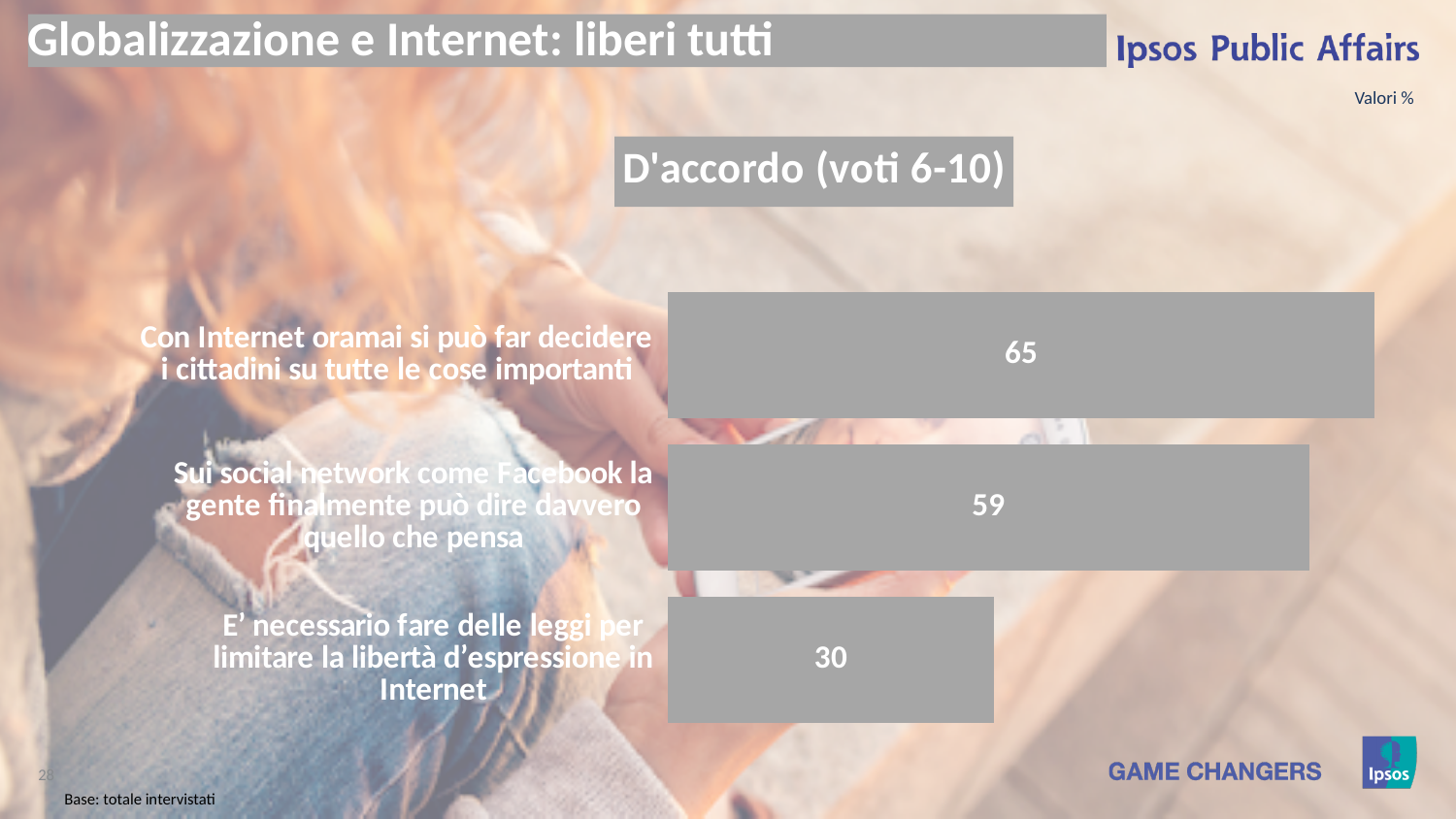
What is the difference between the values for the Internet-decision statement and the Facebook statement? 6 Which statement has the lowest level of agreement? E' necessario fare delle leggi per limitare la libertà d'espressione in Internet What type of chart is shown on the slide? Bar chart What is the value for "E' necessario fare delle leggi per limitare la libertà d'espressione in Internet"? 30 Which statement has the highest level of agreement? Con Internet oramai si può far decidere i cittadini su tutte le cose importanti What is the difference between the highest and lowest values on the chart? 35 How many statements are shown in the chart? 3 What is the value for "Con Internet oramai si può far decidere i cittadini su tutte le cose importanti"? 65 What is the title of the chart? D'accordo (voti 6-10) Which is larger: the value for the Facebook statement or the value for the statement about laws limiting freedom of expression? The Facebook statement (59) In what unit are the values expressed, according to the note at the top right? Valori % What is the value for "Sui social network come Facebook la gente finalmente può dire davvero quello che pensa"? 59